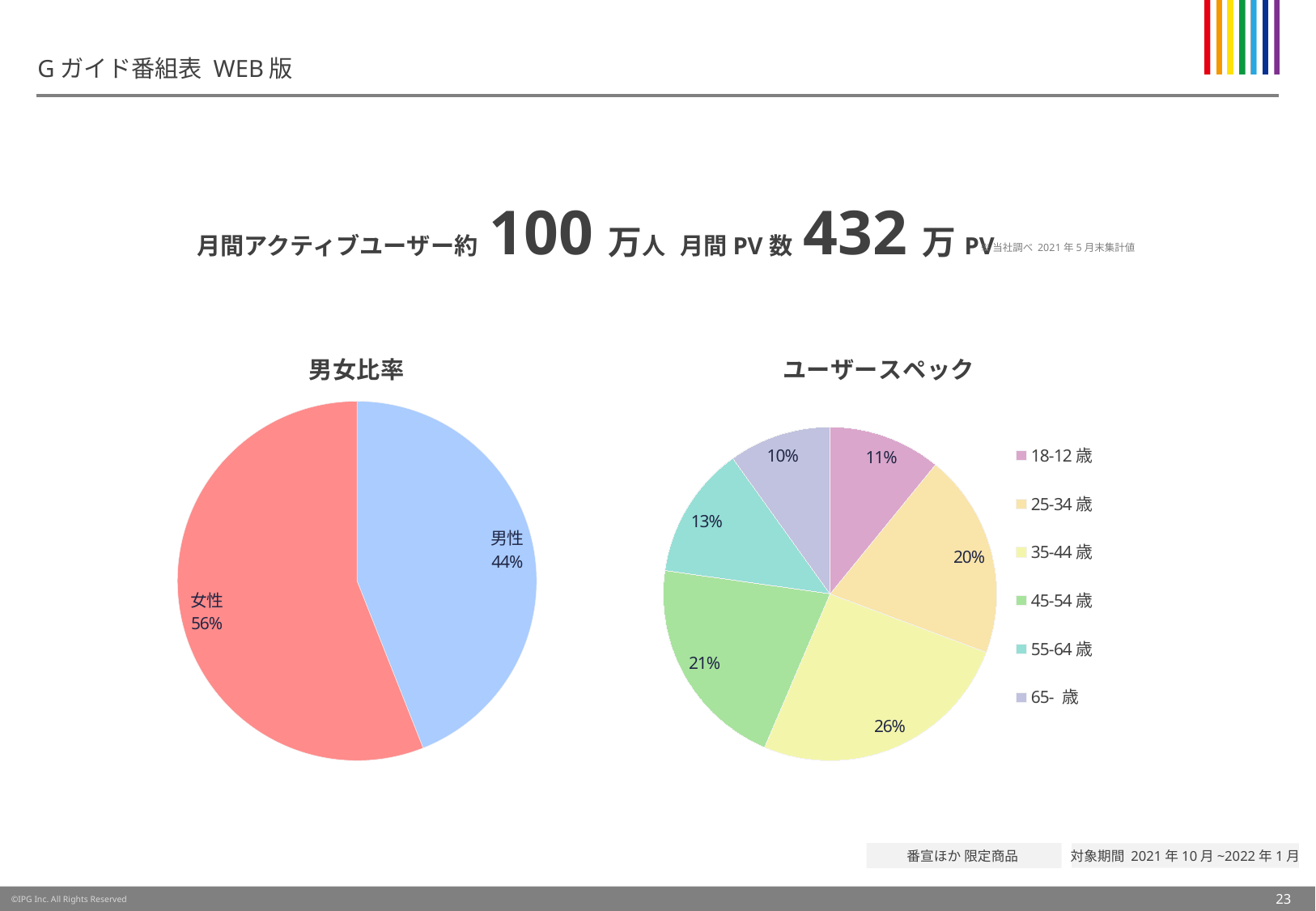
In the ユーザースペック chart, which age group has the largest share? 35-44 歳 In the 男女比率 chart, what share is 女性? 56% In the 男女比率 chart, what share is 男性? 44% In the ユーザースペック chart, what is the difference between the 45-54 歳 and 25-34 歳 shares? 1% In the ユーザースペック chart, what share is 35-44 歳? 26% What kind of chart is the ユーザースペック chart? pie chart How many age groups does the legend of the ユーザースペック chart list? 6 In the ユーザースペック chart, what share is 55-64 歳? 13% In the ユーザースペック chart, what colour is the 45-54 歳 slice? green In the 男女比率 chart, what is the difference between the 女性 and 男性 shares? 12% In the ユーザースペック chart, which age group has the smallest share? 65- 歳 In the 男女比率 chart, which is larger, 女性 or 男性? 女性